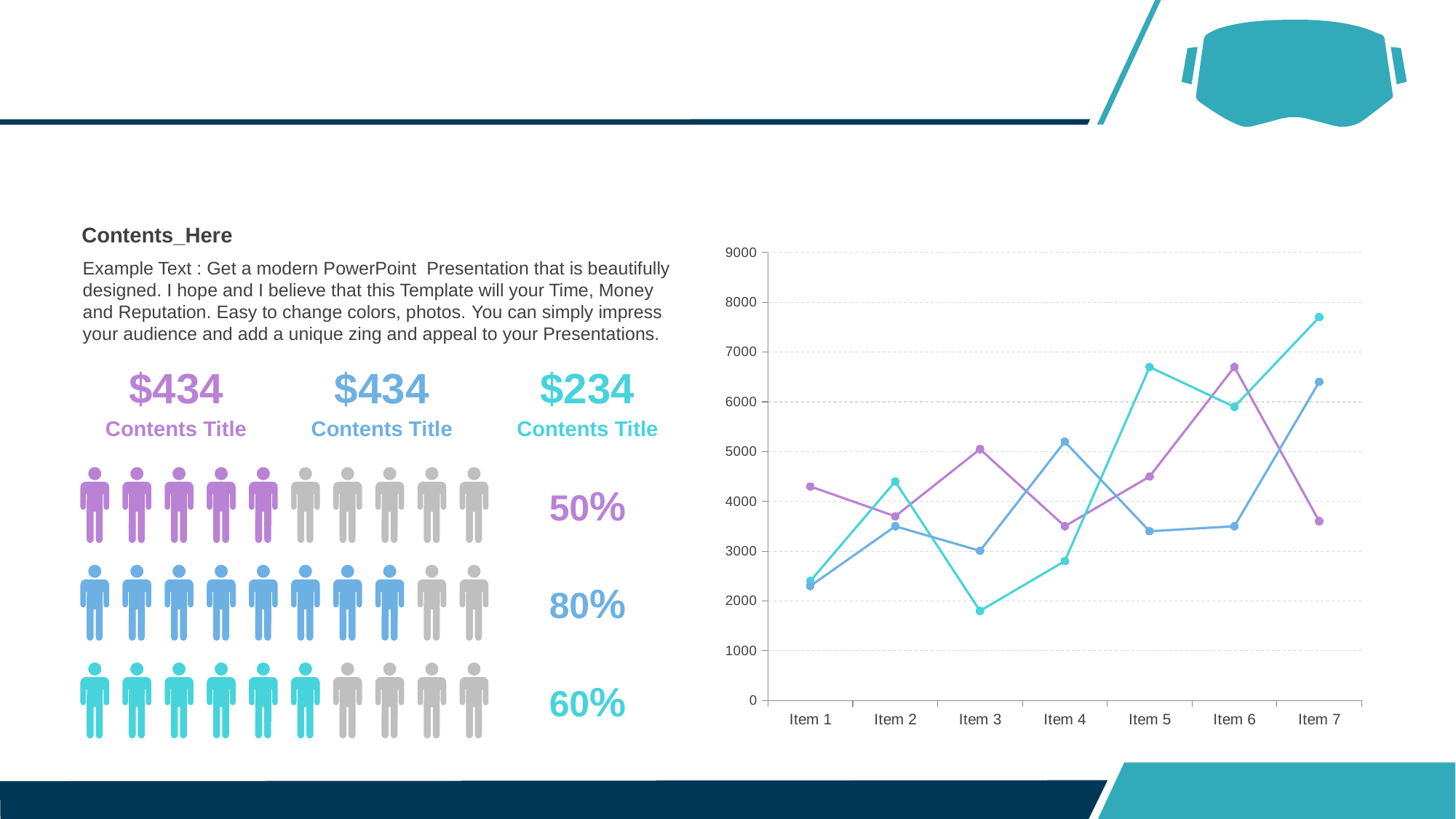
How many items are shown along the x axis of the line chart? 7 At which item does the purple line reach its highest value? Item 6 At which item does the cyan line reach its highest value? Item 7 Is the value of the cyan line at Item 3 greater or less than 2000? less Is the value of the cyan line at Item 7 greater or less than 7000? greater At Item 5, which line has the larger value, the cyan line or the blue line? cyan line Is the value of the purple line at Item 6 greater or less than 6000? greater At Item 7, which line has the larger value, the purple line or the cyan line? cyan line What kind of chart is shown on the right side of the slide? line chart At which item does the cyan line reach its lowest value? Item 3 How many lines are plotted on the line chart? 3